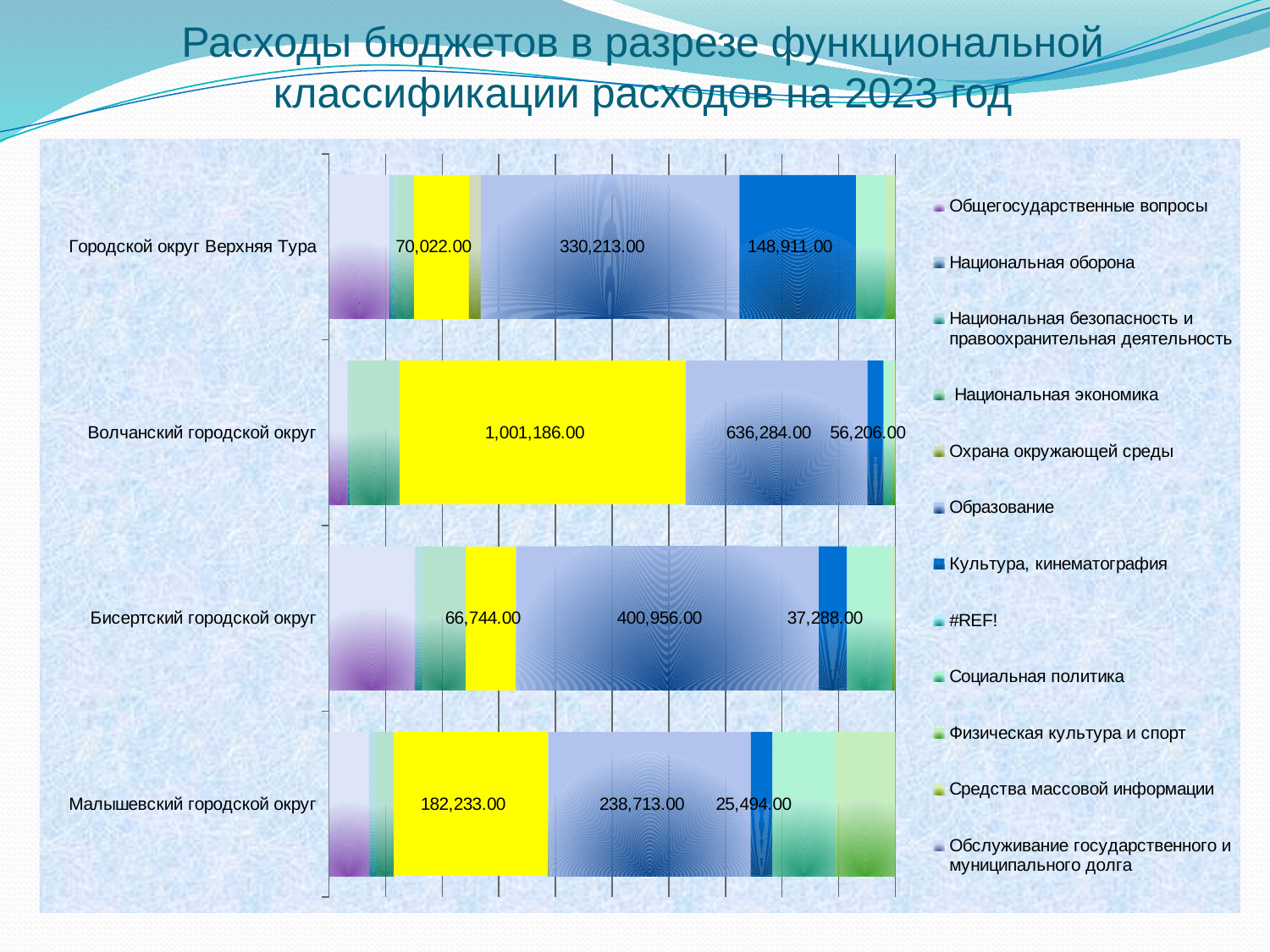
What is the value of the light blue (Образование) segment for Городской округ Верхняя Тура? 330,213.00 For Бисертский городской округ, which is larger: the yellow segment value or the light blue segment value? The light blue segment (400,956.00) What type of chart is shown on the slide? Stacked bar chart What is the value of the yellow segment for Волчанский городской округ? 1,001,186.00 What is the difference between the light blue and dark blue labelled values for Городской округ Верхняя Тура? 181,302.00 What is the value of the dark blue (Культура, кинематография) segment for Бисертский городской округ? 37,288.00 Which legend entry appears as an error reference rather than a category name? #REF! Which municipality has the smallest labelled dark blue (Культура, кинематография) value? Малышевский городской округ What is the value of the yellow segment for Малышевский городской округ? 182,233.00 How many series does the legend list? 12 How many municipalities (categories) are shown on the chart? 4